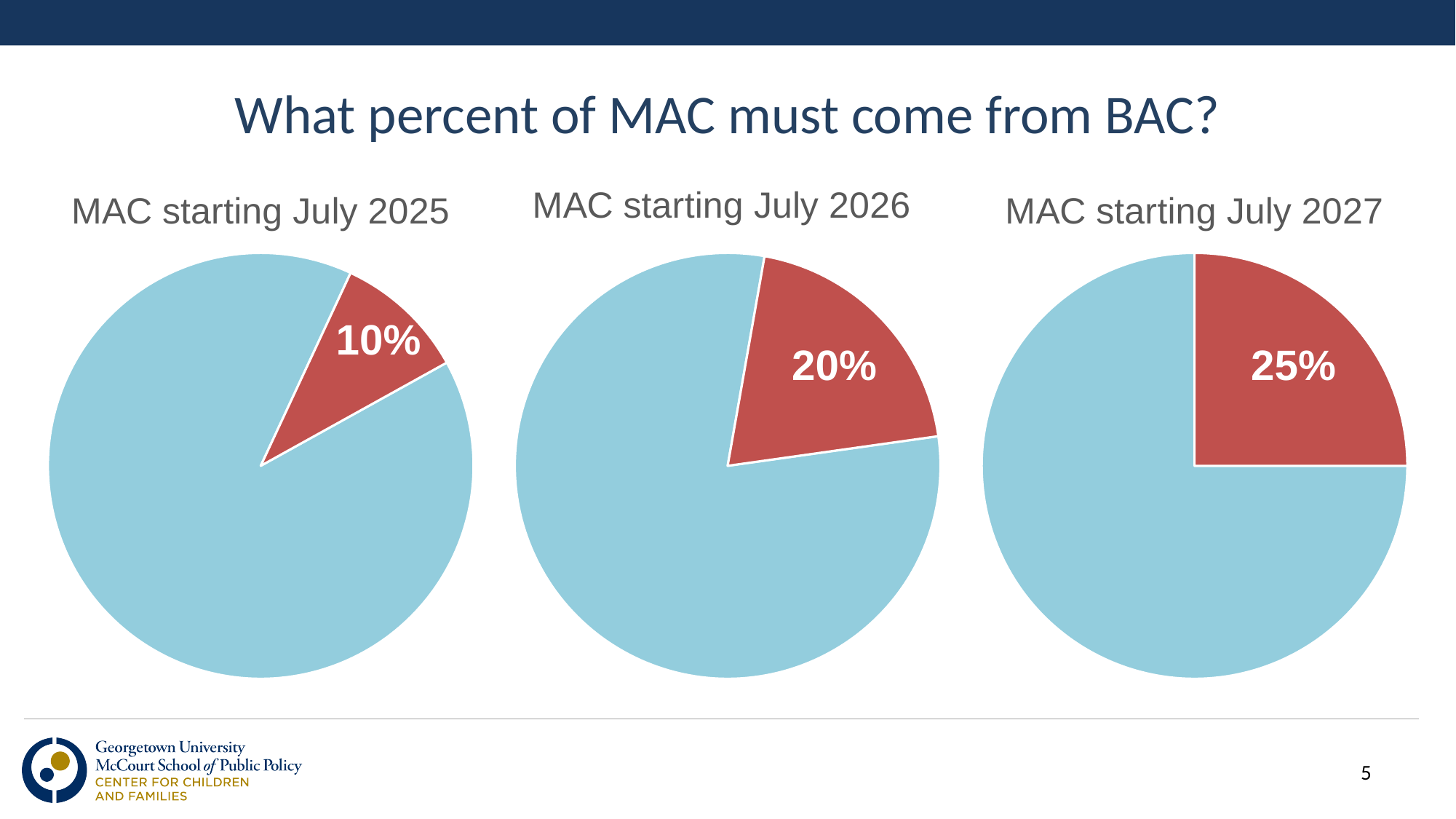
Which chart has the smallest labeled red slice: 'MAC starting July 2025', 'MAC starting July 2026', or 'MAC starting July 2027'? MAC starting July 2025 Is the labeled red slice larger in the 'MAC starting July 2026' chart or the 'MAC starting July 2025' chart? MAC starting July 2026 In the 'MAC starting July 2026' chart, what percentage is shown on the red slice? 20% In the 'MAC starting July 2025' chart, what percentage is shown on the red slice? 10% Across the three charts from July 2025 to July 2027, does the labeled red slice percentage rise or fall? Rise In the 'MAC starting July 2027' chart, what colour is the slice labeled 25%? Red What is the difference between the red slice percentage in the 'MAC starting July 2027' chart and the 'MAC starting July 2025' chart? 15% Which chart has the largest labeled red slice: 'MAC starting July 2025', 'MAC starting July 2026', or 'MAC starting July 2027'? MAC starting July 2027 In the 'MAC starting July 2027' chart, what percentage is shown on the red slice? 25% What kind of chart is the 'MAC starting July 2025' chart? Pie chart How many pie charts are shown on the slide? 3 What is the title of the slide above the three pie charts? What percent of MAC must come from BAC?